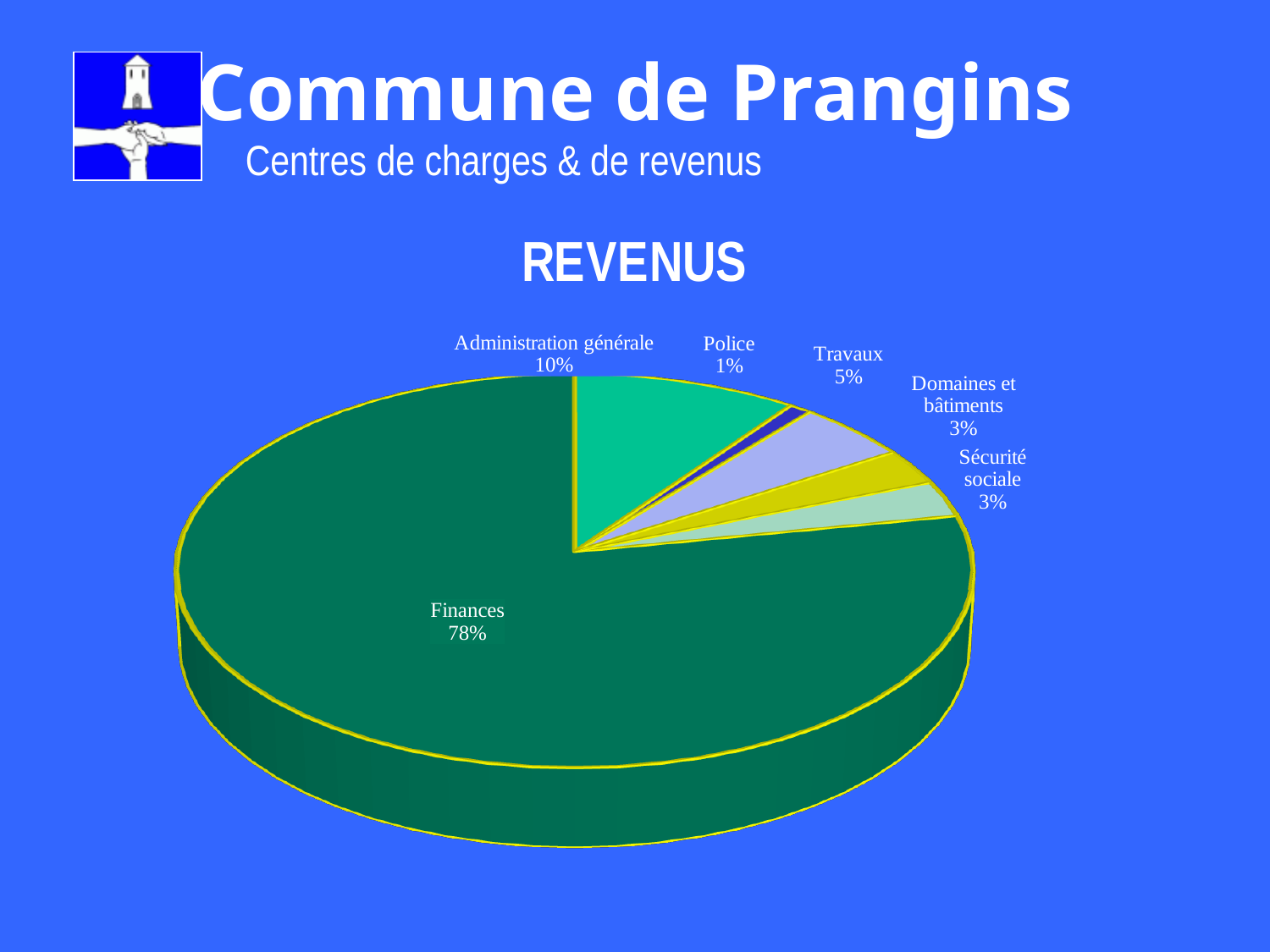
What percentage is shown for Travaux in the REVENUS pie chart? 5% Which category has the largest share in the REVENUS pie chart? Finances What is the title of the chart on the slide? REVENUS Which is larger in the REVENUS pie chart, Travaux or Sécurité sociale? Travaux What type of chart is shown on the slide? Pie chart What percentage is shown for Administration générale in the REVENUS pie chart? 10% Which category has the smallest share in the REVENUS pie chart? Police What share of the REVENUS pie chart does Finances represent? 78% What percentage is shown for Domaines et bâtiments in the REVENUS pie chart? 3% What percentage is shown for Police in the REVENUS pie chart? 1% What is the difference in percentage points between Finances and Administration générale in the REVENUS pie chart? 68 How many slices does the REVENUS pie chart have? 6